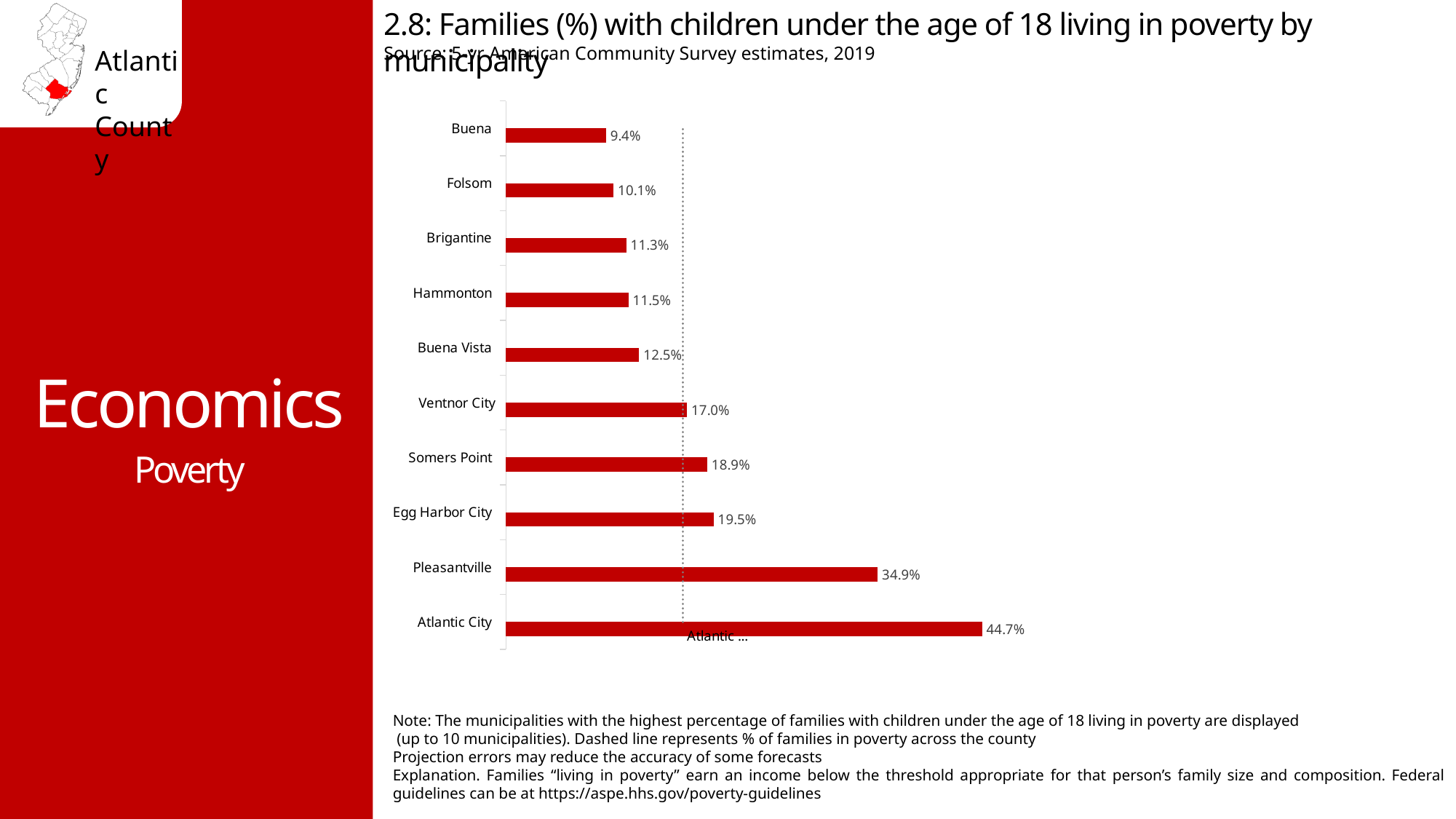
What does the dashed vertical line in the chart represent? % of families in poverty across the county What is the difference between the values for Egg Harbor City and Buena? 10.1% What is the value for Somers Point? 18.9% Which municipality has the lowest percentage of families with children under 18 living in poverty? Buena What is the value for Hammonton? 11.5% Which municipality has the highest percentage of families with children under 18 living in poverty? Atlantic City What is the value for Pleasantville? 34.9% How many municipalities are shown in the chart? 10 Which is larger, the value for Ventnor City or the value for Buena Vista? Ventnor City What is the difference between the values for Atlantic City and Pleasantville? 9.8% What kind of chart is shown on the slide? Bar chart What is the value for Atlantic City? 44.7%